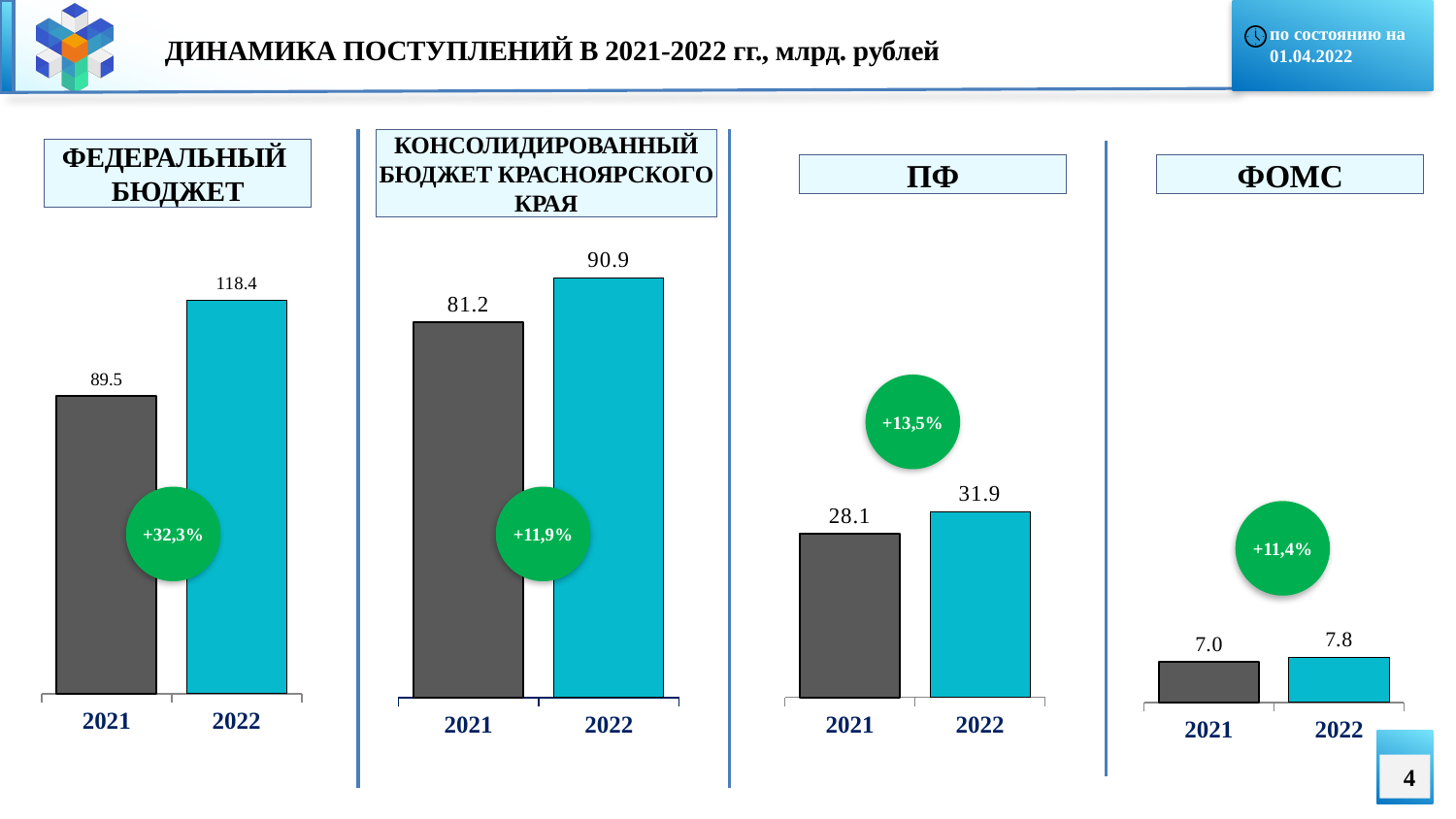
What percentage change is shown in the green circle on the ФЕДЕРАЛЬНЫЙ БЮДЖЕТ chart? +32,3% In the ФОМС chart, what is the difference between the 2022 and 2021 values? 0.8 In the ПФ chart, what is the value for 2021? 28.1 How many bars are shown in the ПФ chart? 2 In the ФЕДЕРАЛЬНЫЙ БЮДЖЕТ chart, what is the value for 2022? 118.4 In the КОНСОЛИДИРОВАННЫЙ БЮДЖЕТ КРАСНОЯРСКОГО КРАЯ chart, what is the difference between the 2022 and 2021 values? 9.7 In the ПФ chart, which year has the higher value, 2021 or 2022? 2022 In the ФЕДЕРАЛЬНЫЙ БЮДЖЕТ chart, do the values rise or fall from 2021 to 2022? rise What type of chart is used for ФОМС? bar chart In the ФОМС chart, what is the value for 2022? 7.8 In the КОНСОЛИДИРОВАННЫЙ БЮДЖЕТ КРАСНОЯРСКОГО КРАЯ chart, what is the value for 2022? 90.9 In the ФЕДЕРАЛЬНЫЙ БЮДЖЕТ chart, what is the value for 2021? 89.5